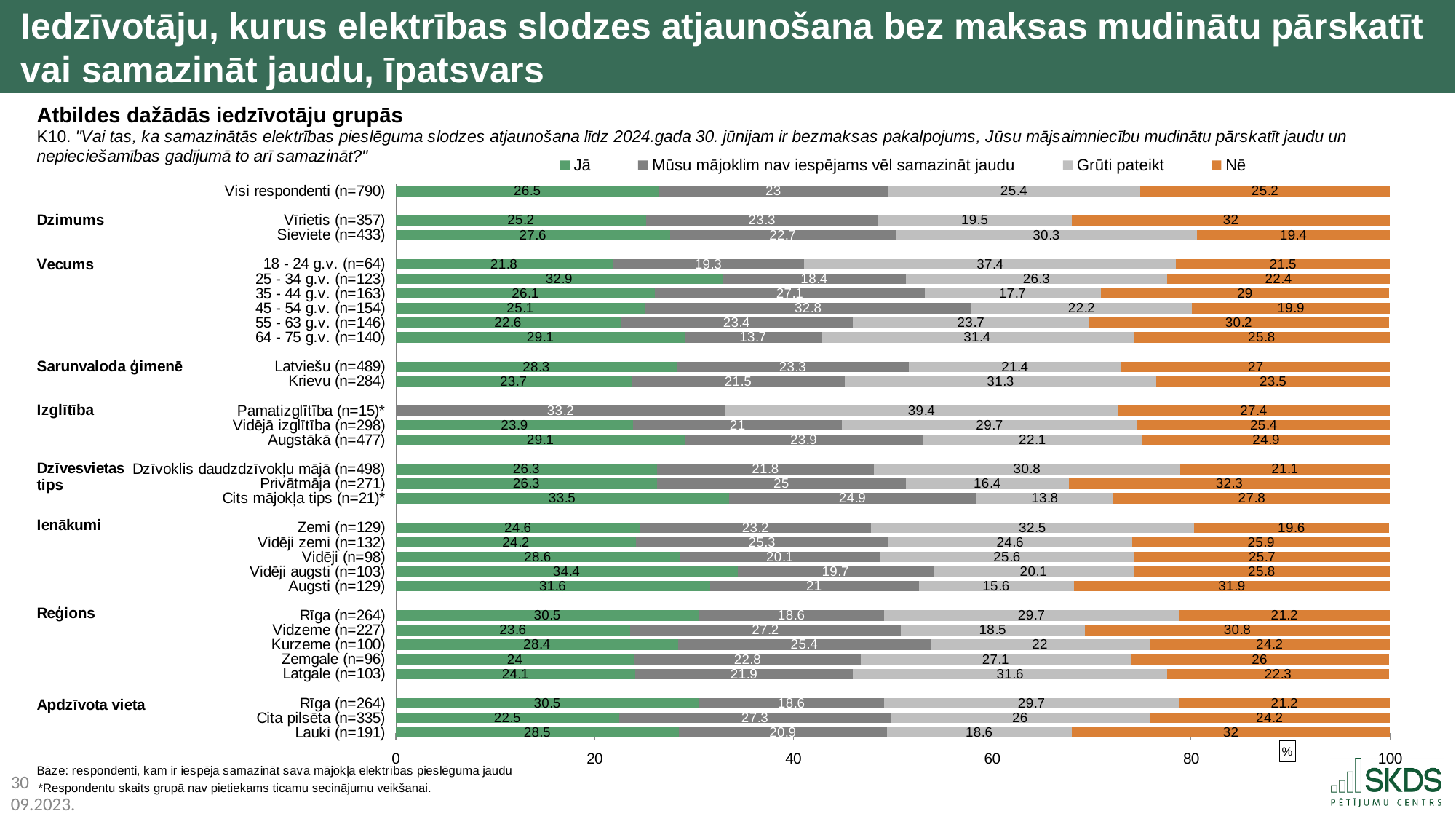
What kind of chart is shown on the slide? Stacked bar chart Among the age groups (Vecums), which has the highest "Jā" value? 25 - 34 g.v. (n=123) What is the value of "Jā" for Visi respondenti (n=790)? 26.5 What is the value of "Grūti pateikt" for Sieviete (n=433)? 30.3 What colour represents "Nē" in the chart? Orange How many series does the legend list? 4 What is the difference between the "Nē" value for Vīrietis (n=357) and for Sieviete (n=433)? 12.6 Which has a larger "Jā" value: Latviešu (n=489) or Krievu (n=284)? Latviešu (n=489) How many groups are listed under Reģions? 5 Among the income groups (Ienākumi), which has the lowest "Grūti pateikt" value? Augsti (n=129) What is the value of "Nē" for Lauki (n=191)? 32 What is the value of "Mūsu mājoklim nav iespējams vēl samazināt jaudu" for Pamatizglītība (n=15)*? 33.2